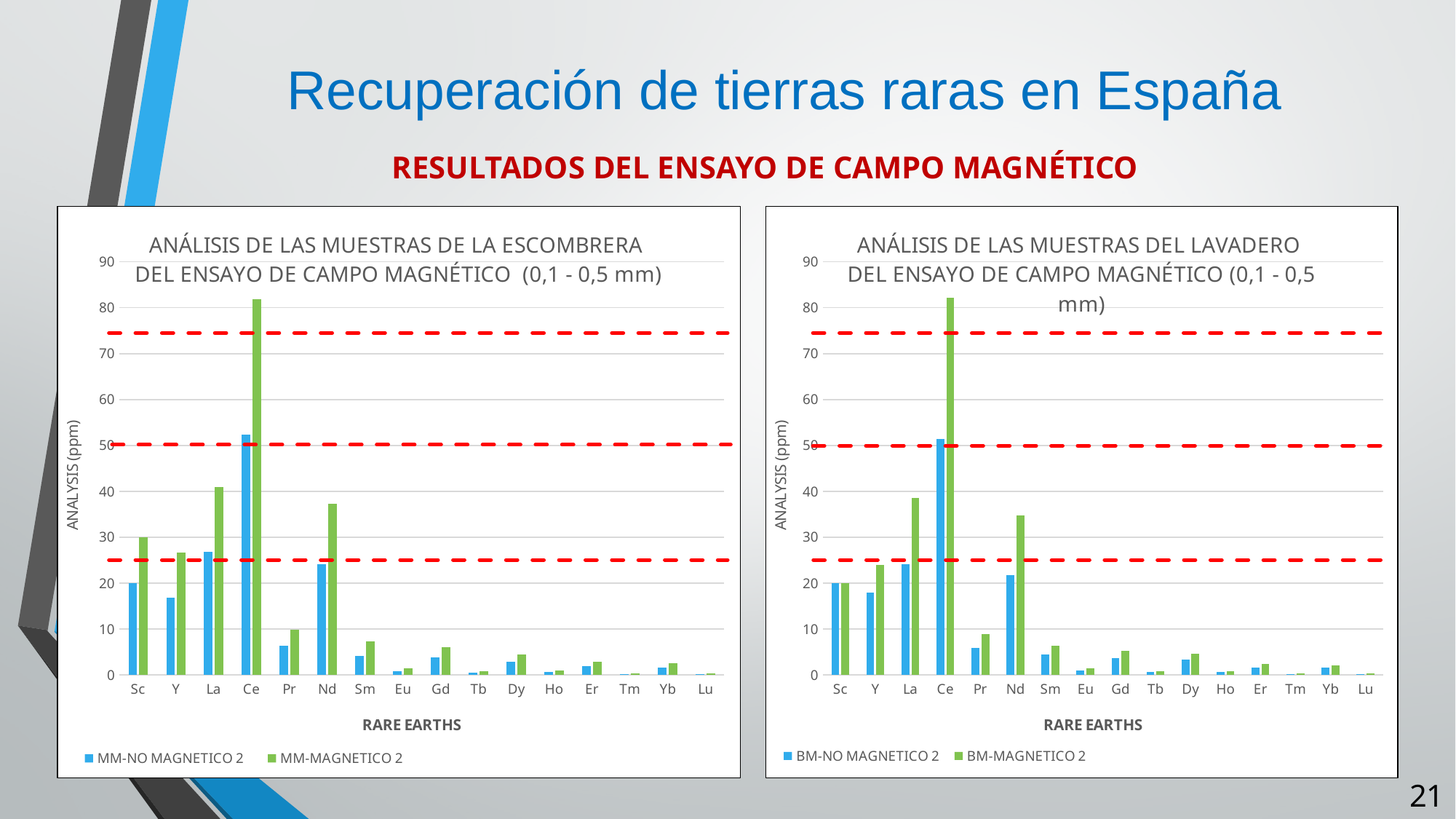
In the right chart, which is larger for BM-MAGNETICO 2: La or Y? La What is the y-axis label of the right chart? ANALYSIS (ppm) What type of chart is the left chart, 'ANÁLISIS DE LAS MUESTRAS DE LA ESCOMBRERA'? Bar chart How many rare earth categories are shown on the x axis of the right chart, 'ANÁLISIS DE LAS MUESTRAS DEL LAVADERO'? 16 In the left chart, is the MM-NO MAGNETICO 2 value for Y greater or less than 20? less How many series does the legend of the left chart list? 2 In the left chart, which rare earth has the highest MM-MAGNETICO 2 value? Ce In the right chart, is the BM-MAGNETICO 2 value for Nd greater or less than 30? greater In the right chart, which rare earth has the highest BM-NO MAGNETICO 2 value? Ce In the right chart, is the BM-MAGNETICO 2 value for La greater or less than 40? less In the left chart, which is larger for MM-MAGNETICO 2: Ce or Nd? Ce